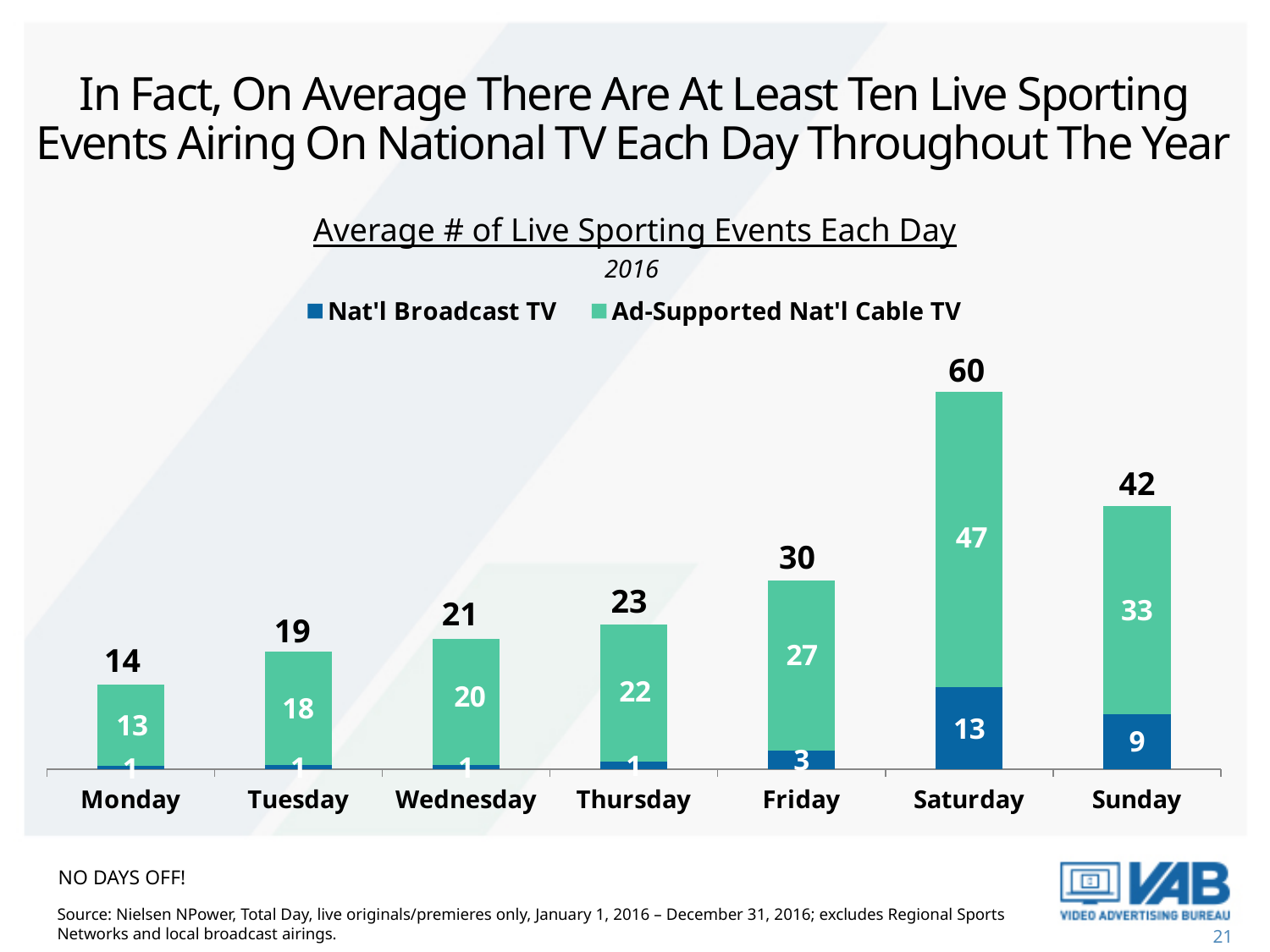
What kind of chart is shown on the slide? Stacked bar chart What is the total of the stacked bar for Wednesday? 21 What is the total of the stacked bar for Saturday? 60 What is the Nat'l Broadcast TV value for Friday? 3 Which is larger, the Ad-Supported Nat'l Cable TV value for Friday or for Thursday? Friday Which day has the lowest total average number of live sporting events? Monday What is the Ad-Supported Nat'l Cable TV value for Saturday? 47 How many series does the legend list? 2 Which day has the highest total average number of live sporting events? Saturday What is the Nat'l Broadcast TV value for Sunday? 9 What is the difference between the Saturday total and the Sunday total? 18 How many days are shown on the x axis? 7